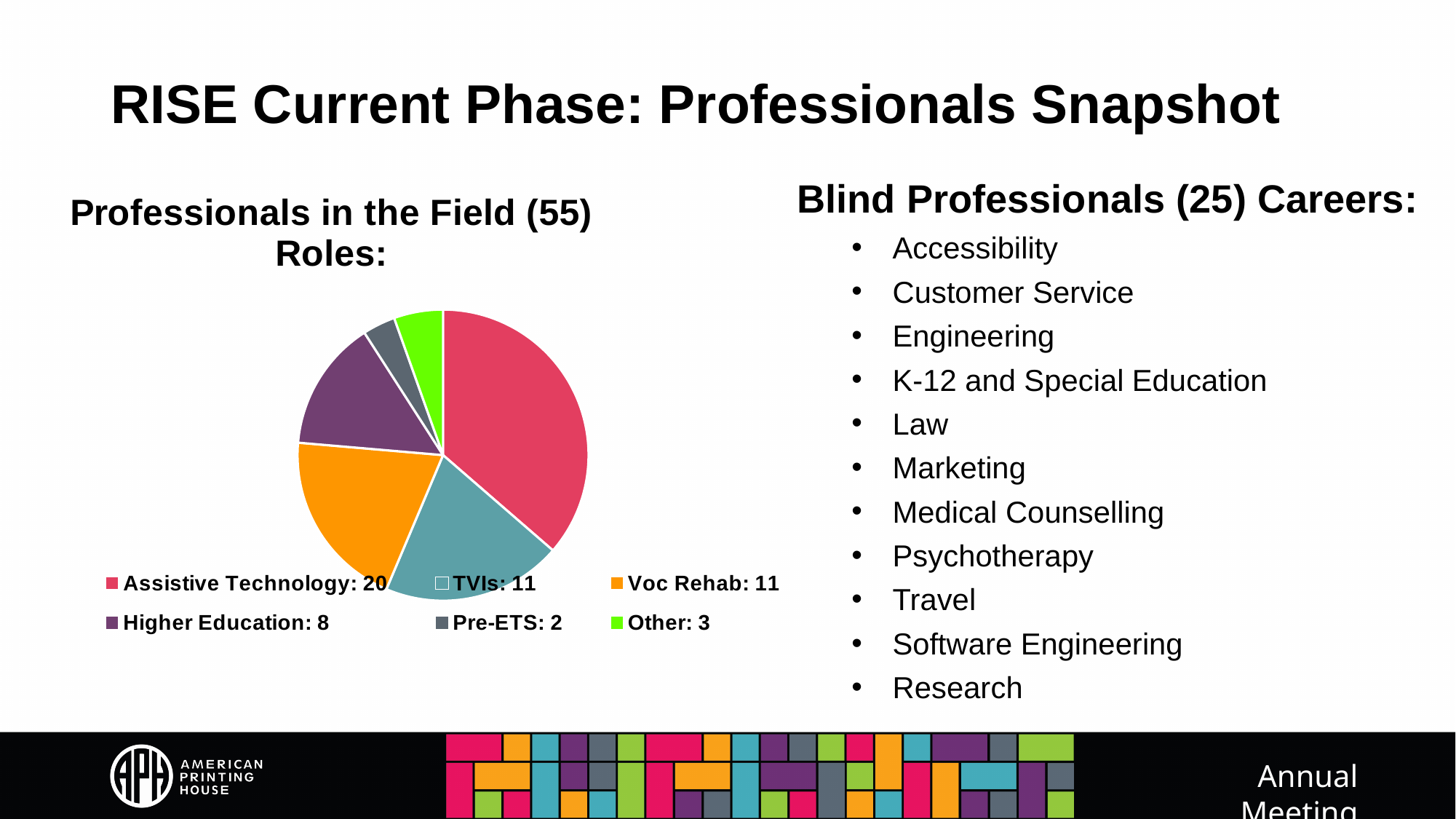
Which role has the largest slice of the pie chart? Assistive Technology How many professionals in the field work in Assistive Technology? 20 Which role has the smallest slice of the pie chart? Pre-ETS What is the value for Higher Education in the pie chart? 8 What is the total number of professionals represented in the pie chart? 55 What is the difference between the Assistive Technology and Voc Rehab values? 9 How many role categories does the pie chart show? 6 Which is larger, Higher Education or Other? Higher Education How many professionals in the field are TVIs? 11 What colour is the Voc Rehab slice in the pie chart? Orange What type of chart is shown on the slide? Pie chart What is the value for Pre-ETS in the pie chart? 2